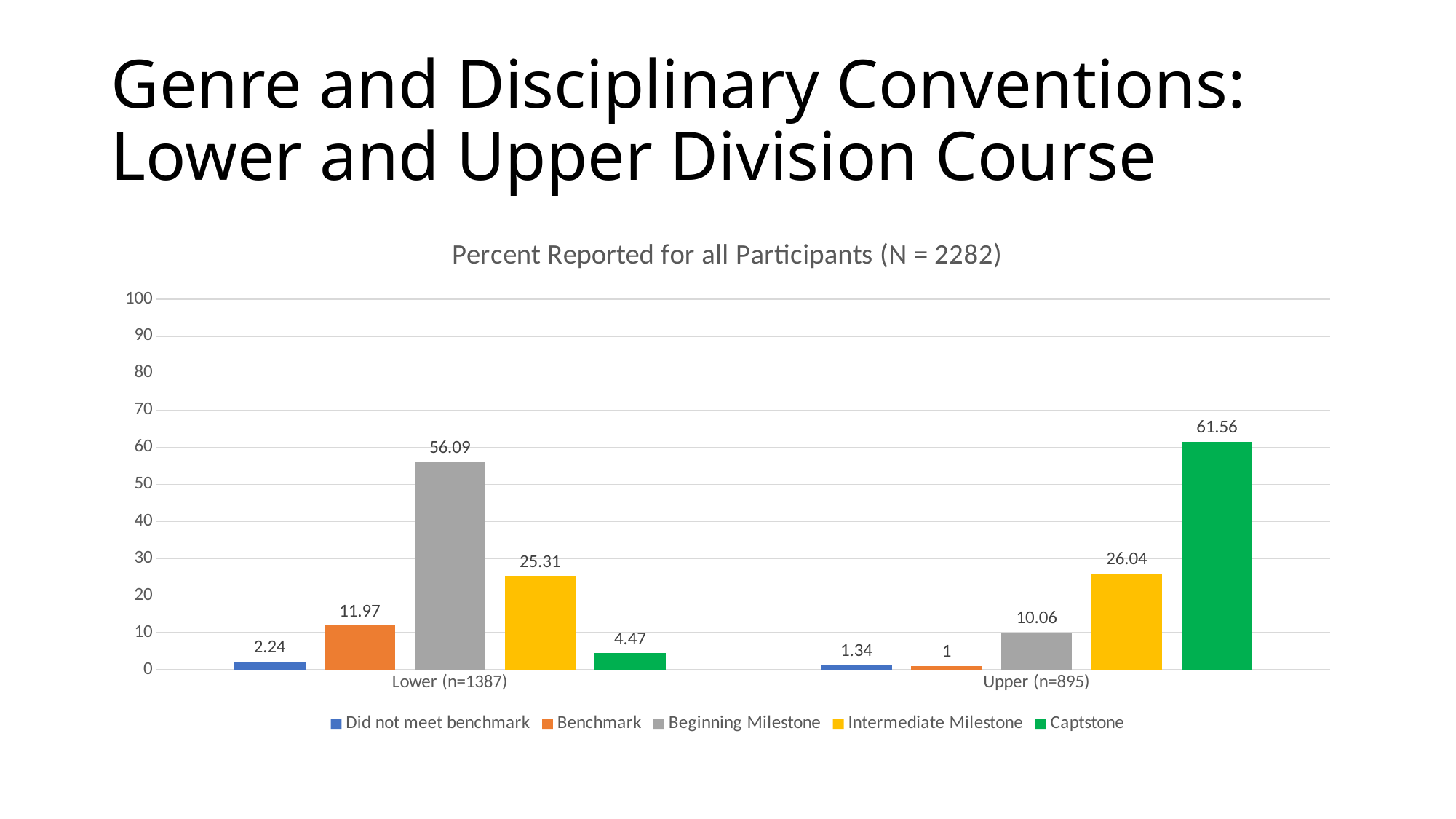
Which is larger: Intermediate Milestone for Lower (n=1387) or Intermediate Milestone for Upper (n=895)? Upper (n=895) What is the difference between the Captstone values for Upper (n=895) and Lower (n=1387)? 57.09 How many categories are shown on the x axis? 2 How many series does the legend list? 5 Is the value for Beginning Milestone in the Upper (n=895) group greater or less than 20? less What is the title of the chart? Percent Reported for all Participants (N = 2282) Which series has the lowest value in the Upper (n=895) group? Benchmark What kind of chart is shown on the slide? Bar chart What is the value for Benchmark in the Upper (n=895) group? 1 Which series has the highest value in the Lower (n=1387) group? Beginning Milestone What is the value for Captstone in the Upper (n=895) group? 61.56 What is the value for Beginning Milestone in the Lower (n=1387) group? 56.09